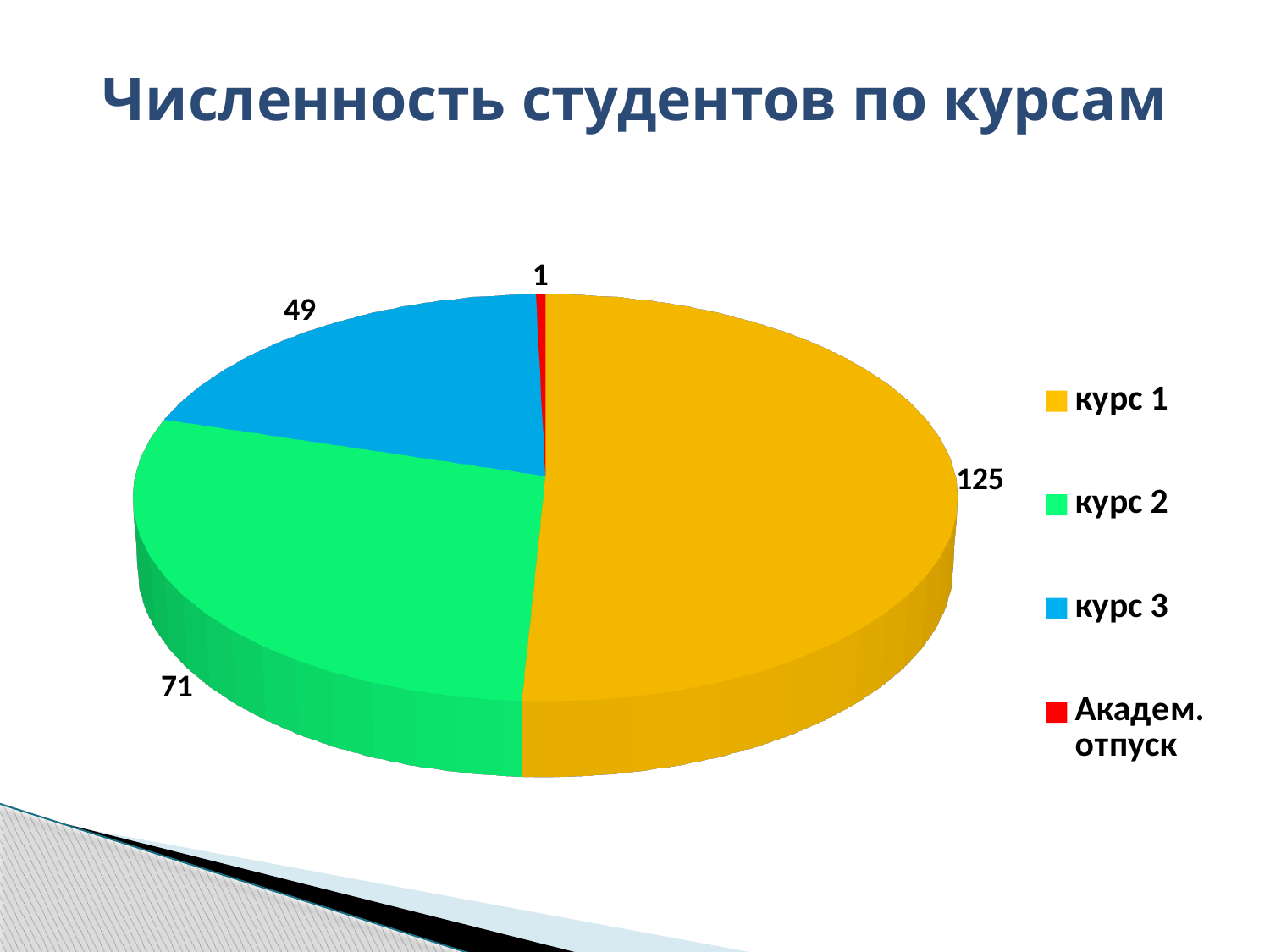
Which category has the smallest slice? Академ. отпуск How many entries does the legend list? 4 What kind of chart is shown on the slide? Pie chart Which category has the largest slice? курс 1 What is the title of the chart? Численность студентов по курсам How many slices does the pie chart have? 4 What is the value for курс 2? 71 What is the difference between the values for курс 1 and курс 2? 54 Which is larger, the value for курс 2 or the value for курс 3? курс 2 What is the value for курс 1? 125 What is the value for курс 3? 49 What is the value for Академ. отпуск? 1